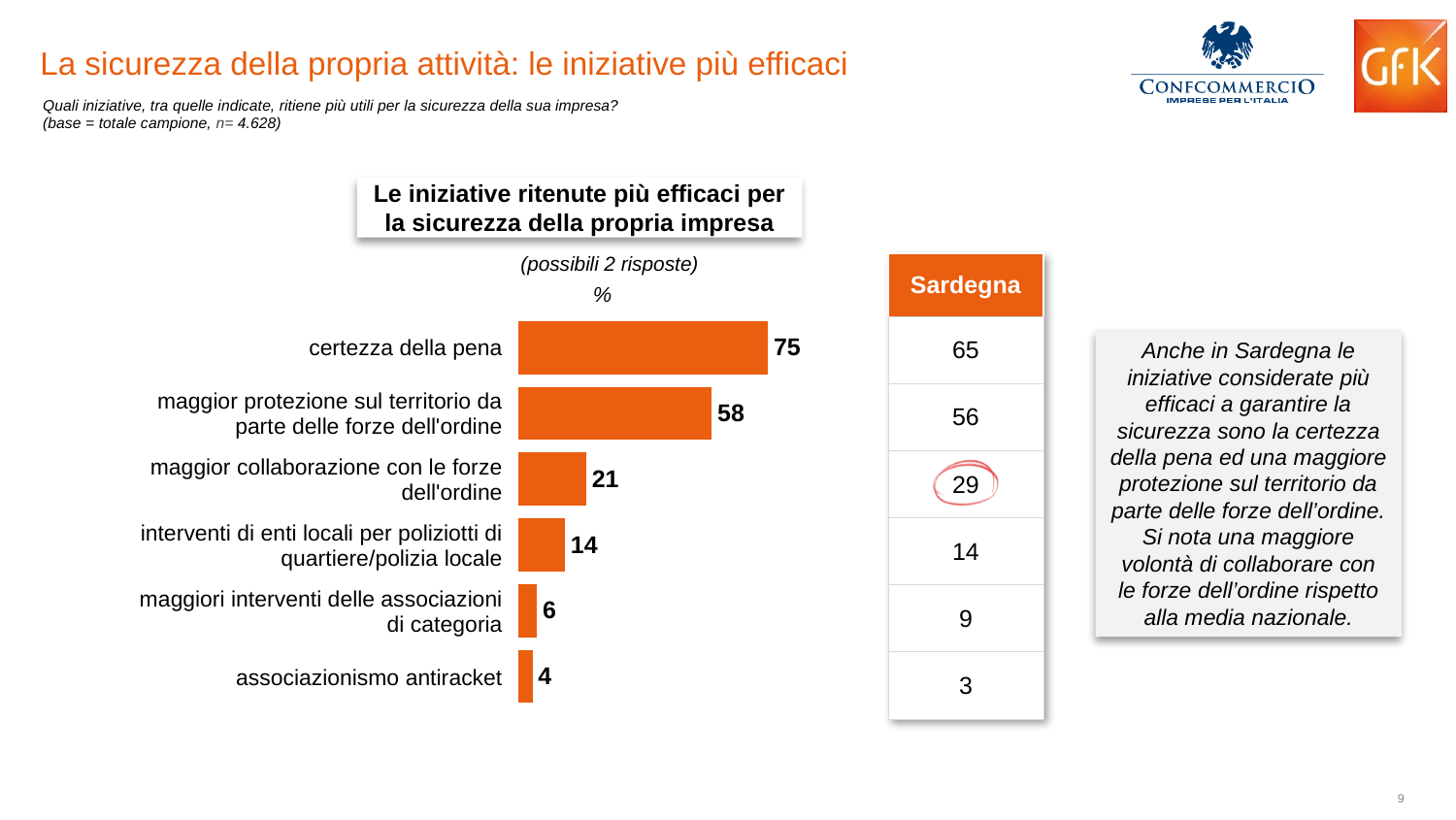
What is the value for "certezza della pena" in the bar chart? 75 Which category has the highest value in the bar chart? certezza della pena In the Sardegna column next to the chart, what is the value for "maggior collaborazione con le forze dell'ordine"? 29 What is the value for "maggior collaborazione con le forze dell'ordine" in the bar chart? 21 Which is larger in the bar chart: "interventi di enti locali per poliziotti di quartiere/polizia locale" or "maggiori interventi delle associazioni di categoria"? interventi di enti locali per poliziotti di quartiere/polizia locale What kind of chart is shown on the slide? bar chart How many categories are shown in the bar chart? 6 Which category has the lowest value in the bar chart? associazionismo antiracket What is the value for "associazionismo antiracket" in the bar chart? 4 What is the title of the chart? Le iniziative ritenute più efficaci per la sicurezza della propria impresa What is the value for "maggior protezione sul territorio da parte delle forze dell'ordine" in the bar chart? 58 What is the difference between the values for "certezza della pena" and "maggior protezione sul territorio da parte delle forze dell'ordine" in the bar chart? 17